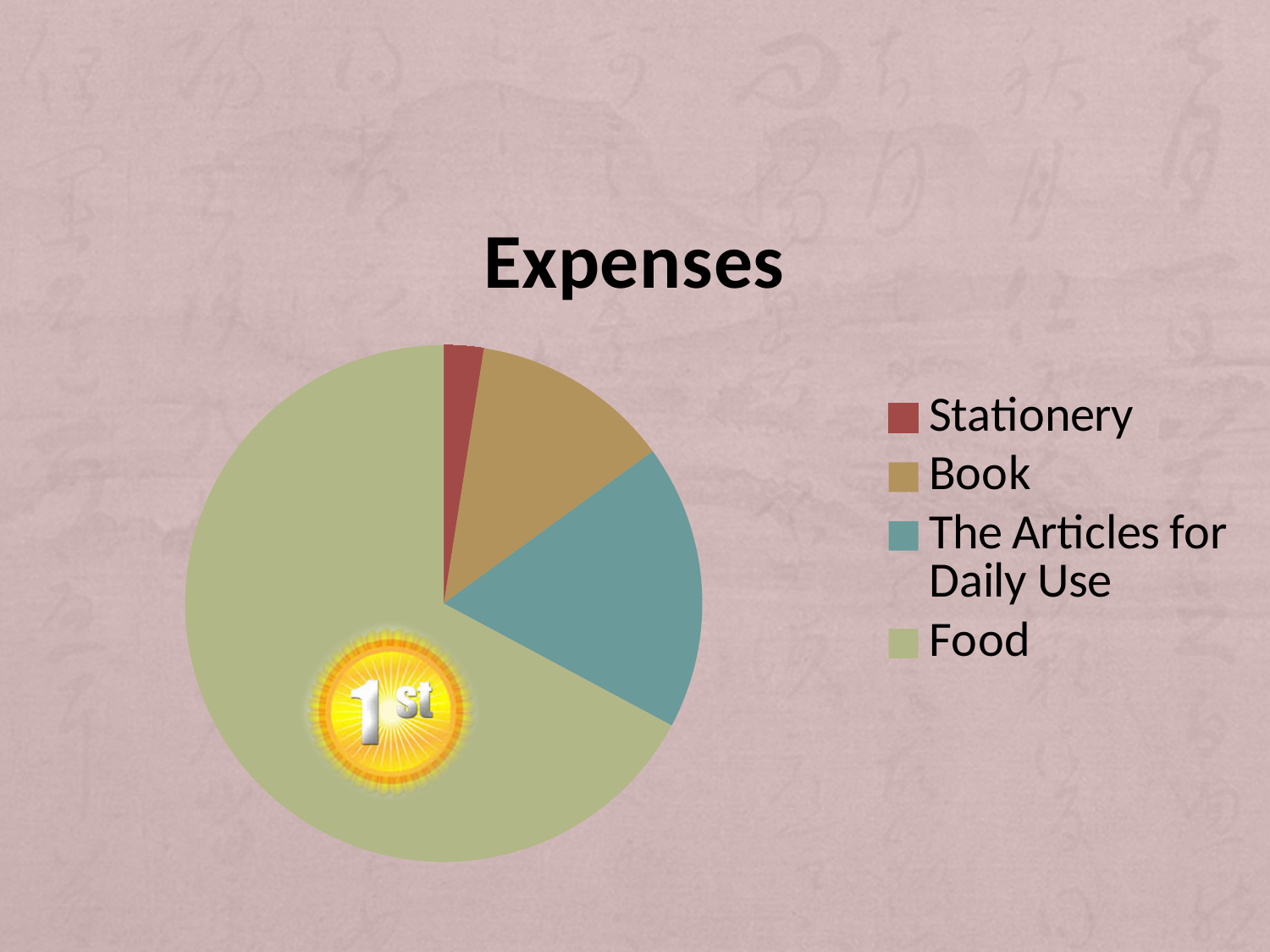
Which category has the smallest slice of the pie? Stationery Which slice is larger, Stationery or Book? Book Which slice is larger, Book or The Articles for Daily Use? The Articles for Daily Use Does the Food slice take up more or less than half of the pie? more Which category is shown in green in the pie chart? Food What is the title of the chart? Expenses What kind of chart is shown on the slide? pie chart How many categories does the pie chart have? 4 Which category has the largest slice of the pie? Food